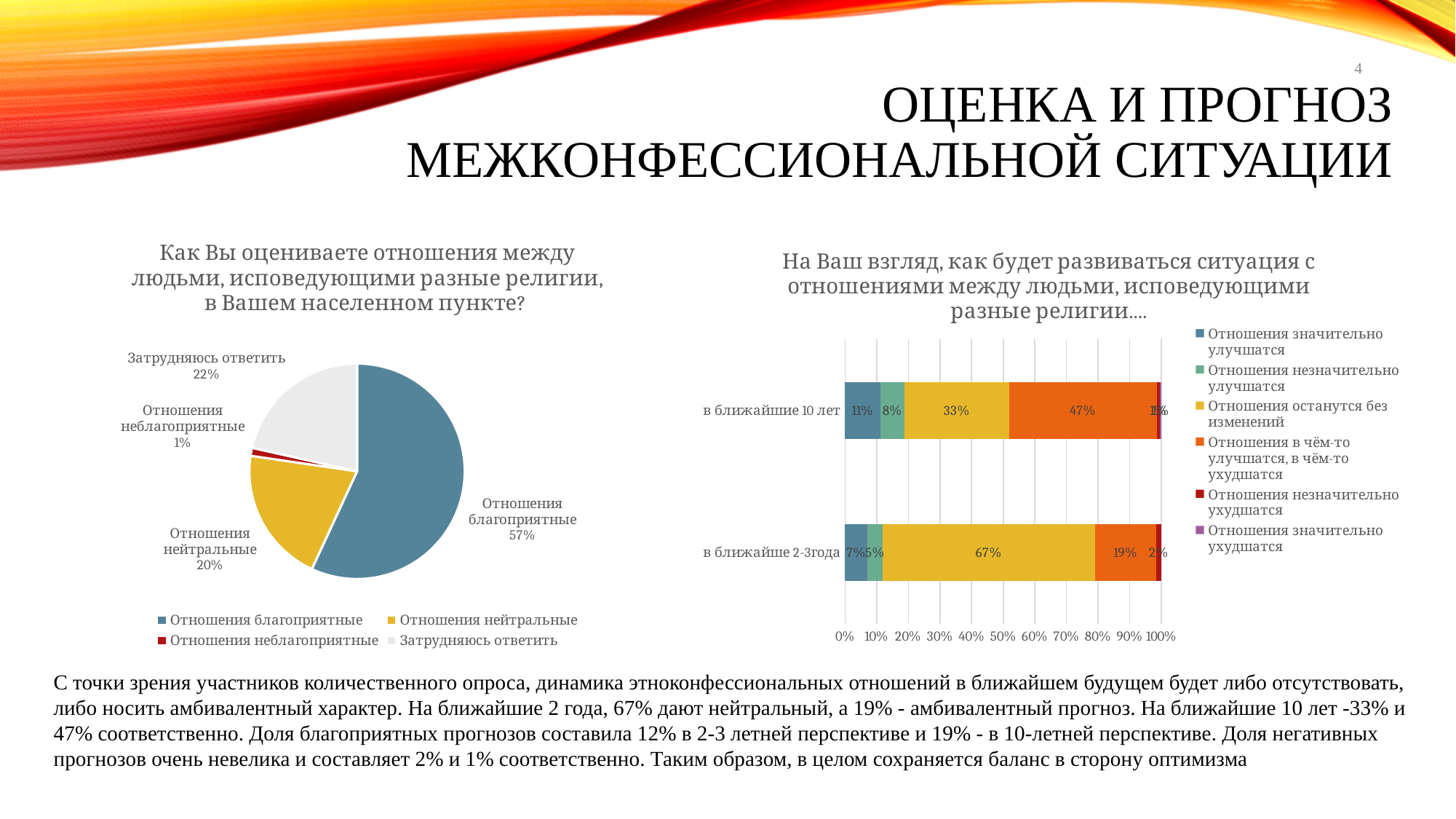
In the right chart, what is the value of "Отношения в чём-то улучшатся, в чём-то ухудшатся" for "в ближайшие 10 лет"? 47% In the left pie chart, what is the difference between "Отношения благоприятные" and "Отношения нейтральные"? 37% In the right chart ("На Ваш взгляд, как будет развиваться ситуация..."), what is the value of "Отношения останутся без изменений" for "в ближайше 2-3года"? 67% In the left pie chart, what is the value for "Затрудняюсь ответить"? 22% In the left pie chart, which category has the largest share? Отношения благоприятные What type of chart is the right chart on the slide? Bar chart In the right chart, which is larger for "в ближайшие 10 лет": "Отношения значительно улучшатся" or "Отношения незначительно улучшатся"? Отношения значительно улучшатся In the left chart ("Как Вы оцениваете отношения между людьми..."), what share of respondents answered "Отношения благоприятные"? 57% How many categories (bars) are shown in the right chart? 2 What type of chart is the left chart on the slide? Pie chart How many series does the legend of the right chart list? 6 In the left pie chart, which category has the smallest share? Отношения неблагоприятные